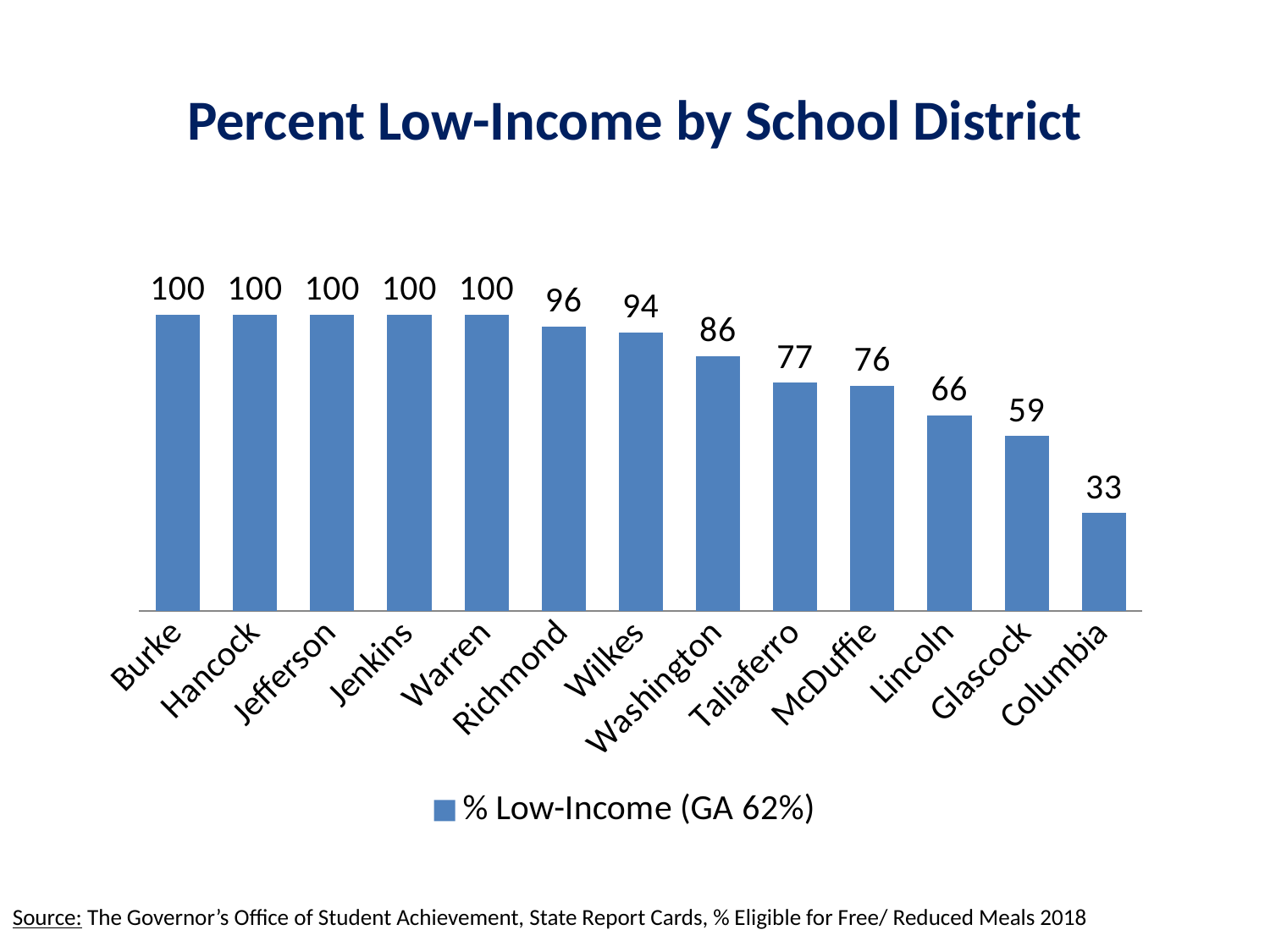
What is the value for Richmond? 96 What is the value for Washington? 86 What is the value for Columbia? 33 Which is larger, the value for Lincoln or the value for Glascock? Lincoln What is the difference between the values for Wilkes and Glascock? 35 What kind of chart is shown on the slide? Bar chart How many school districts are shown on the chart? 13 What is the difference between the values for Taliaferro and McDuffie? 1 What is the legend entry for the series? % Low-Income (GA 62%) Which school district has the lowest value? Columbia How many series does the legend list? 1 Do the values rise or fall from left to right along the x axis? Fall